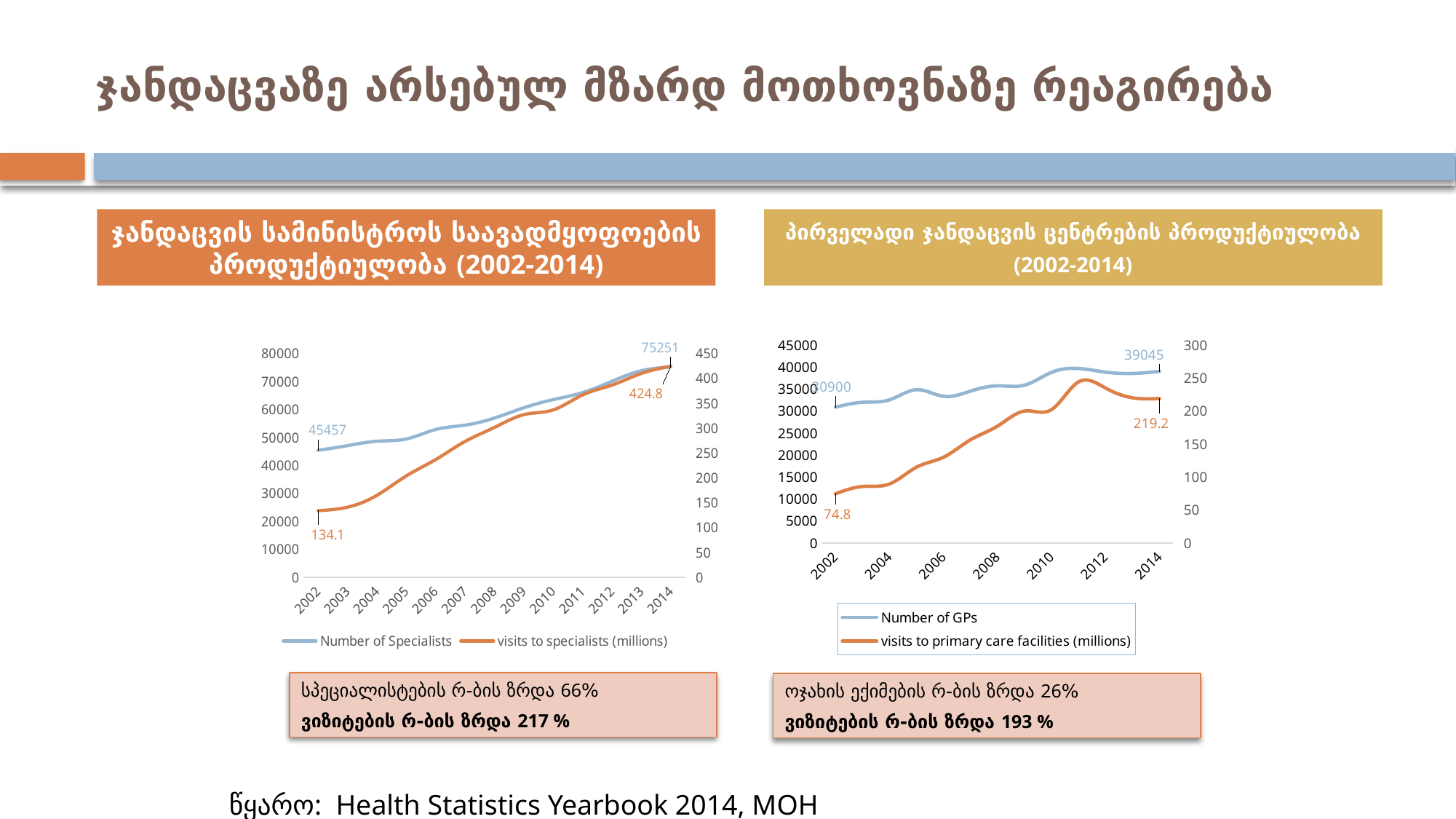
In the left chart, does the visits to specialists (millions) series rise or fall from 2002 to 2014? rise In the left chart, what is the Number of Specialists in 2014? 75251 How many series does the legend of the left chart list? 2 In the left chart, what is the Number of Specialists in 2002? 45457 In the left chart, what is the difference between visits to specialists (millions) in 2014 and in 2002? 290.7 In the right chart, what is the value of visits to primary care facilities (millions) in 2014? 219.2 In the left chart, what is the value of visits to specialists (millions) in 2014? 424.8 What type of chart is the right chart? line chart In the right chart, what is the Number of GPs in 2014? 39045 In the left chart, by how much did the Number of Specialists increase from 2002 to 2014? 29794 In the right chart, is the Number of GPs in 2008 greater or less than 30000? greater In the right chart, what is the value of visits to primary care facilities (millions) in 2002? 74.8